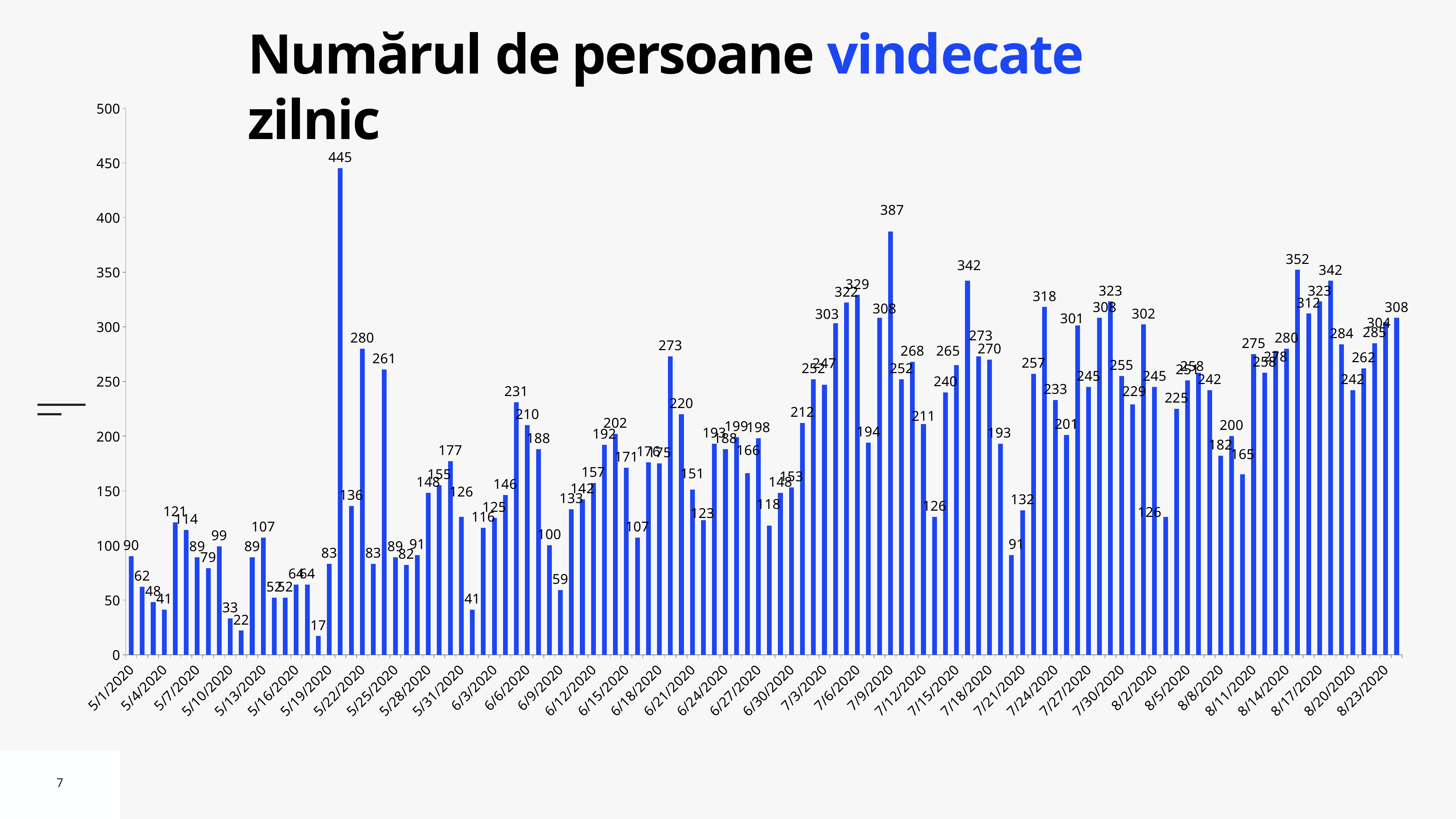
What is the value for 5/22/2020? 280 Overall, do the values rise or fall from May to August along the x axis? rise What is the lowest value shown in the chart? 17 Which is larger, the value for 7/9/2020 or the value for 7/6/2020? 7/9/2020 What kind of chart is shown on the slide? bar chart What is the highest value shown in the chart? 445 What is the difference between the highest value (445) and the second highest value (387)? 58 Is the value for 5/1/2020 greater or less than 100? less What is the value for 7/6/2020? 329 What is the title of the chart on the slide? Numărul de persoane vindecate zilnic What is the value for 7/9/2020? 387 What is the value for 5/1/2020? 90